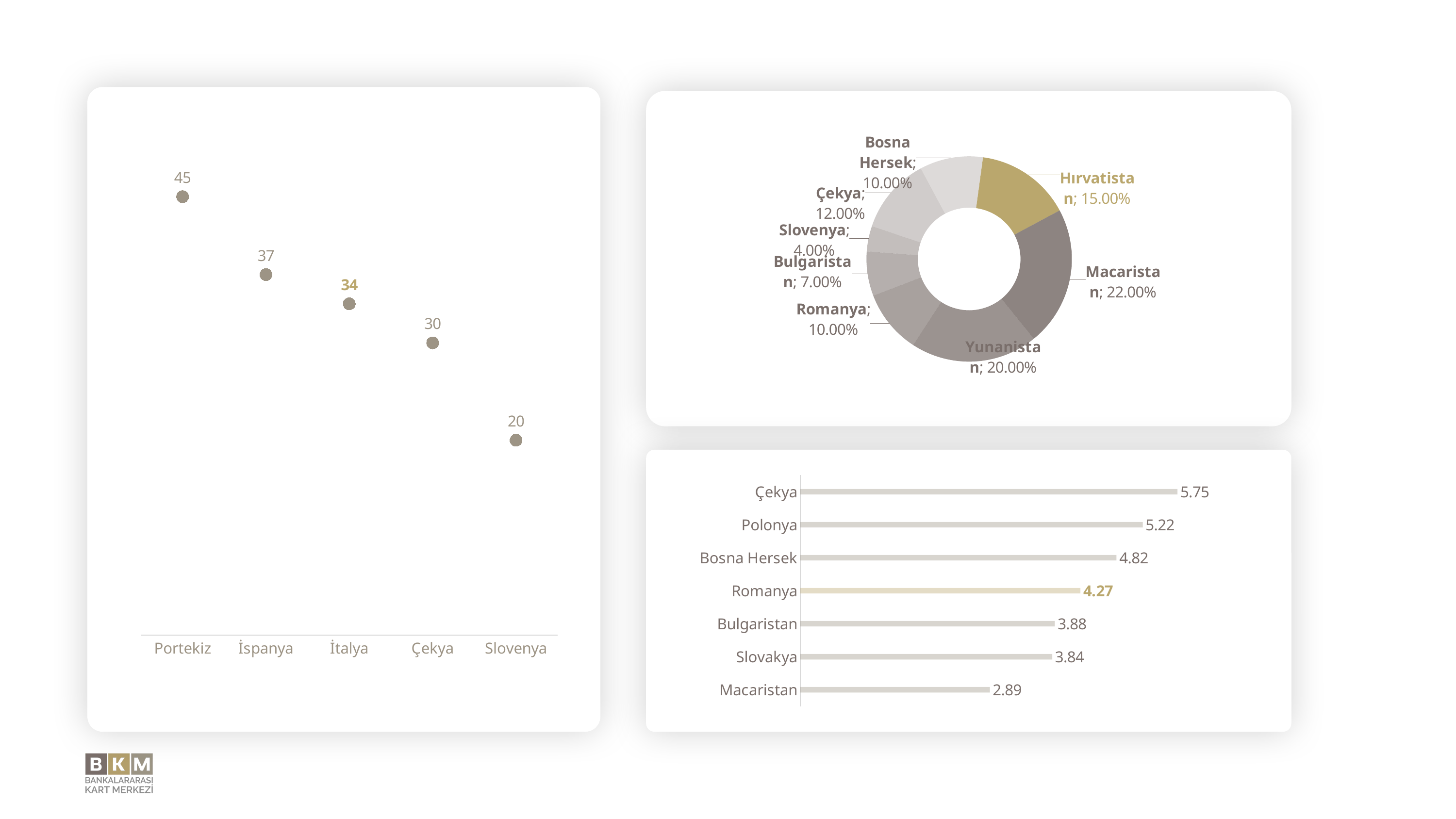
In the chart on the left, what is the difference between the values for İspanya and Çekya? 7 In the donut chart at the top right, what share does Macaristan have? 22.00% In the chart on the left, which category has the lowest value? Slovenya In the bar chart at the bottom right, which category has the highest value? Çekya How many categories are plotted in the chart on the left? 5 In the donut chart at the top right, which is larger, Hırvatistan or Çekya? Hırvatistan What kind of chart is shown at the bottom right of the slide? bar chart How many slices does the donut chart at the top right have? 8 In the donut chart at the top right, which slice is the smallest? Slovenya In the chart on the left, what is the value for Portekiz? 45 In the chart on the left, do the values rise or fall from Portekiz to Slovenya? fall In the bar chart at the bottom right, what is the value for Romanya? 4.27